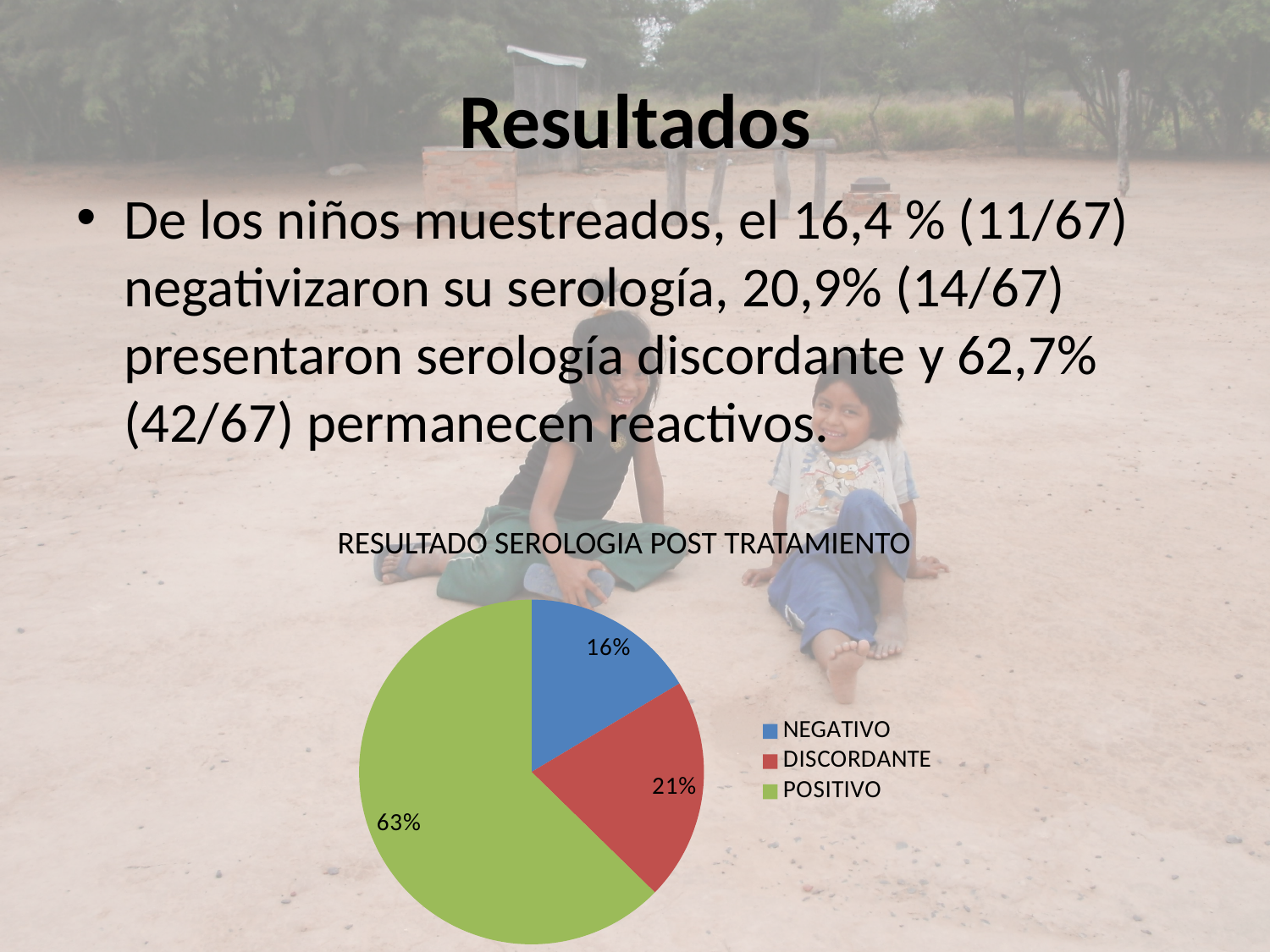
What type of chart is shown on the slide? pie chart What colour is the POSITIVO slice in the pie chart? green What is the difference in percentage points between the POSITIVO slice and the DISCORDANTE slice? 42 What percentage of the pie is labelled for NEGATIVO? 16% What percentage of the pie is labelled for POSITIVO? 63% Which category has the smallest slice of the pie? NEGATIVO Which is larger, the DISCORDANTE slice or the NEGATIVO slice? DISCORDANTE Which category has the largest slice of the pie? POSITIVO How many categories does the legend list? 3 How many slices does the pie chart have? 3 What percentage of the pie is labelled for DISCORDANTE? 21% What is the title of the chart? RESULTADO SEROLOGIA POST TRATAMIENTO